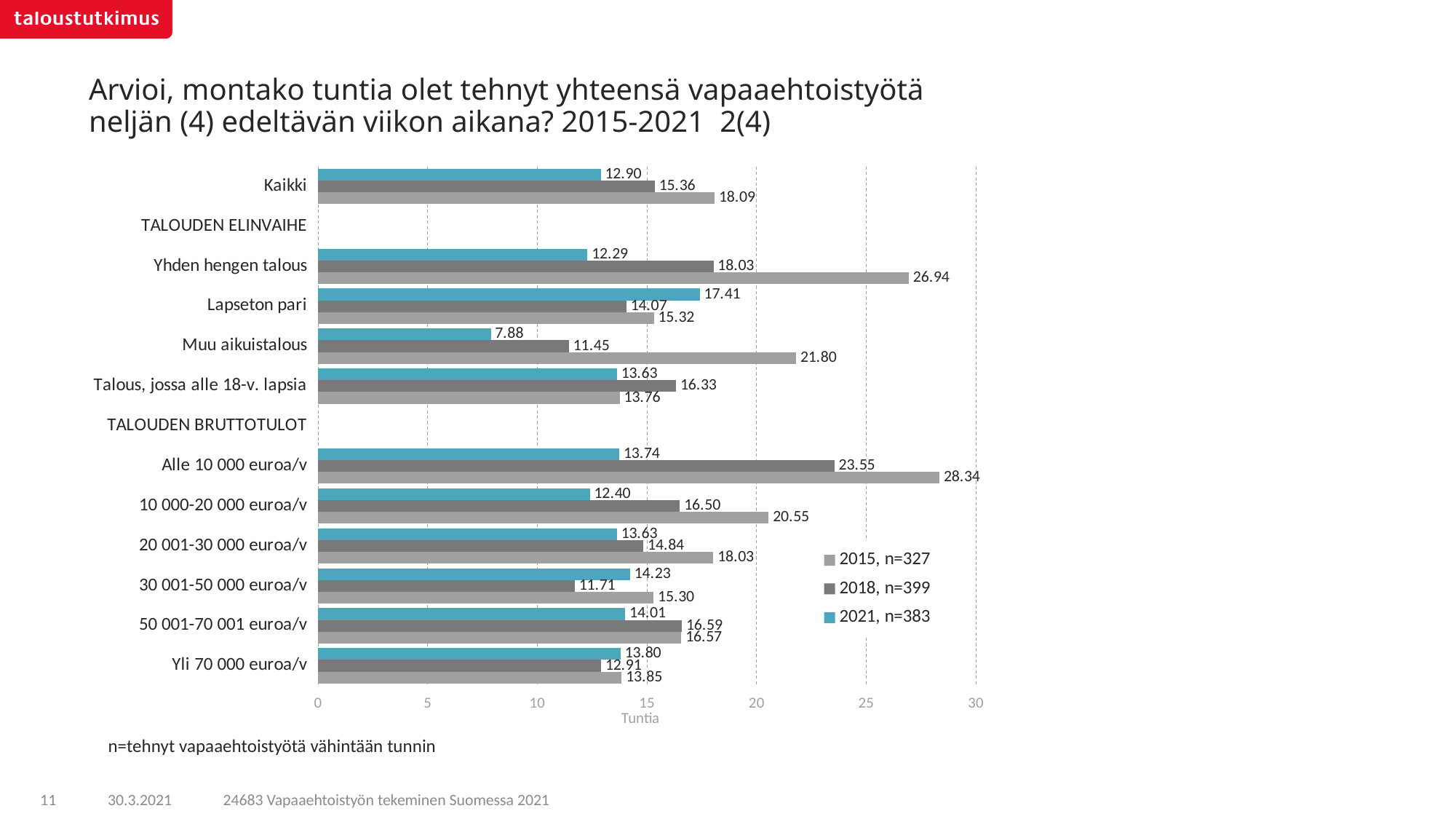
What is the 2015 value for Yhden hengen talous? 26.94 What kind of chart is shown on the slide? Bar chart Which category has the lowest 2021 value? Muu aikuistalous What is the 2021 value for Kaikki? 12.90 Which category has the highest 2015 value? Alle 10 000 euroa/v What is the difference between the 2015 and 2021 values for Muu aikuistalous? 13.92 What is the label of the horizontal axis? Tuntia What is the sample size (n) for the 2018 series in the legend? 399 Which is larger for Lapseton pari, the 2021 value or the 2018 value? 2021 (17.41) How many series does the legend list? 3 What is the 2018 value for Alle 10 000 euroa/v? 23.55 Is the 2015 value for Alle 10 000 euroa/v greater or less than 25? greater